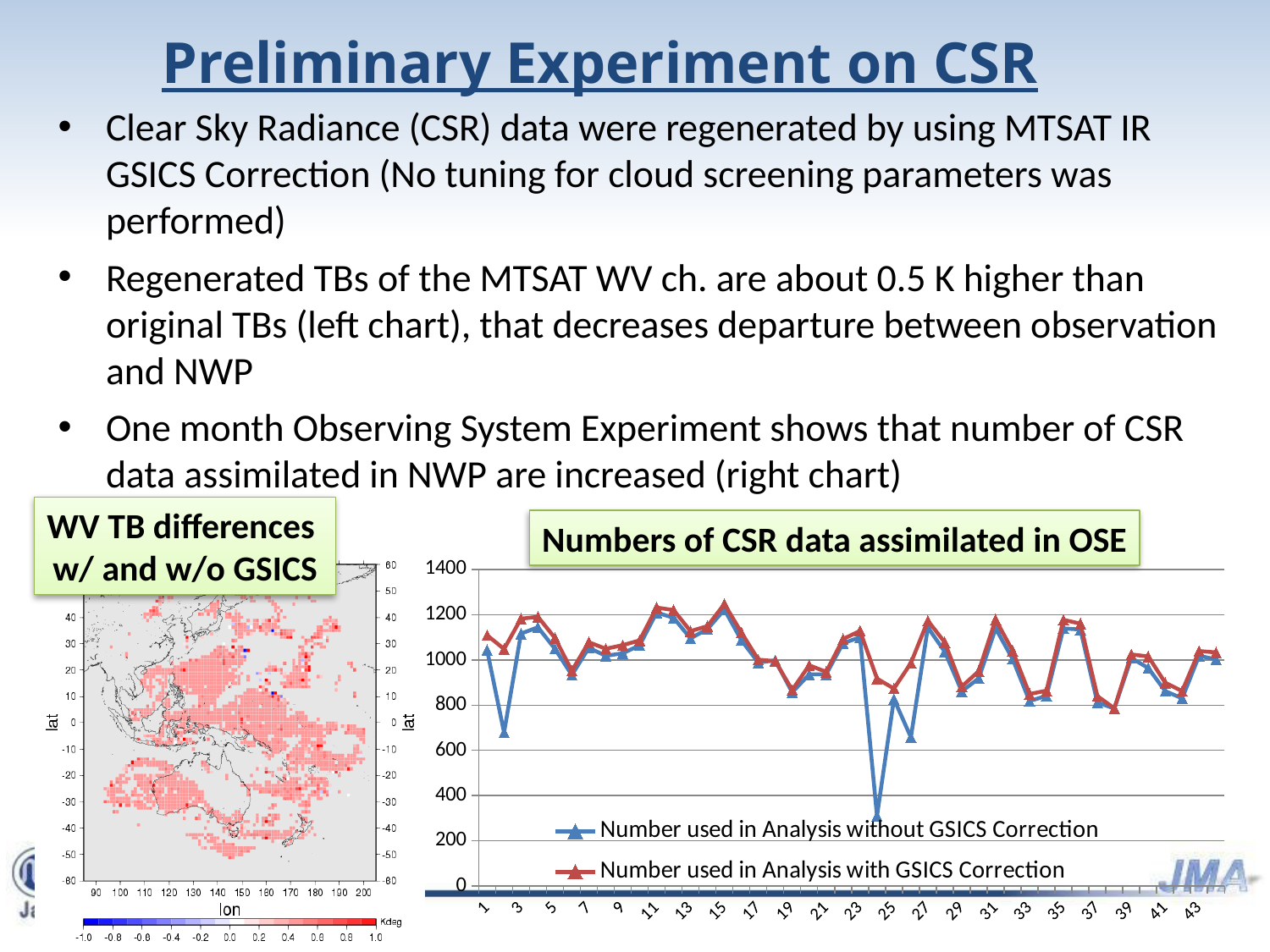
In the 'Numbers of CSR data assimilated in OSE' chart, at which x value does 'Number used in Analysis without GSICS Correction' reach its lowest point? 24 In the 'Numbers of CSR data assimilated in OSE' chart, which series has the larger value at x = 24? Number used in Analysis with GSICS Correction In the 'Numbers of CSR data assimilated in OSE' chart, is the value of 'Number used in Analysis without GSICS Correction' at x = 24 greater or less than 400? less In the 'Numbers of CSR data assimilated in OSE' chart, is the value of 'Number used in Analysis with GSICS Correction' at x = 1 greater or less than 1000? greater In the 'Numbers of CSR data assimilated in OSE' chart, what is the legend entry for the blue series? Number used in Analysis without GSICS Correction In the 'Numbers of CSR data assimilated in OSE' chart, is the value of 'Number used in Analysis without GSICS Correction' at x = 2 greater or less than 800? less How many series does the legend of the 'Numbers of CSR data assimilated in OSE' chart list? 2 In the 'Numbers of CSR data assimilated in OSE' chart, which series has the larger value at x = 26? Number used in Analysis with GSICS Correction What kind of chart is 'Numbers of CSR data assimilated in OSE'? line chart In the 'Numbers of CSR data assimilated in OSE' chart, what is the legend entry for the red series? Number used in Analysis with GSICS Correction